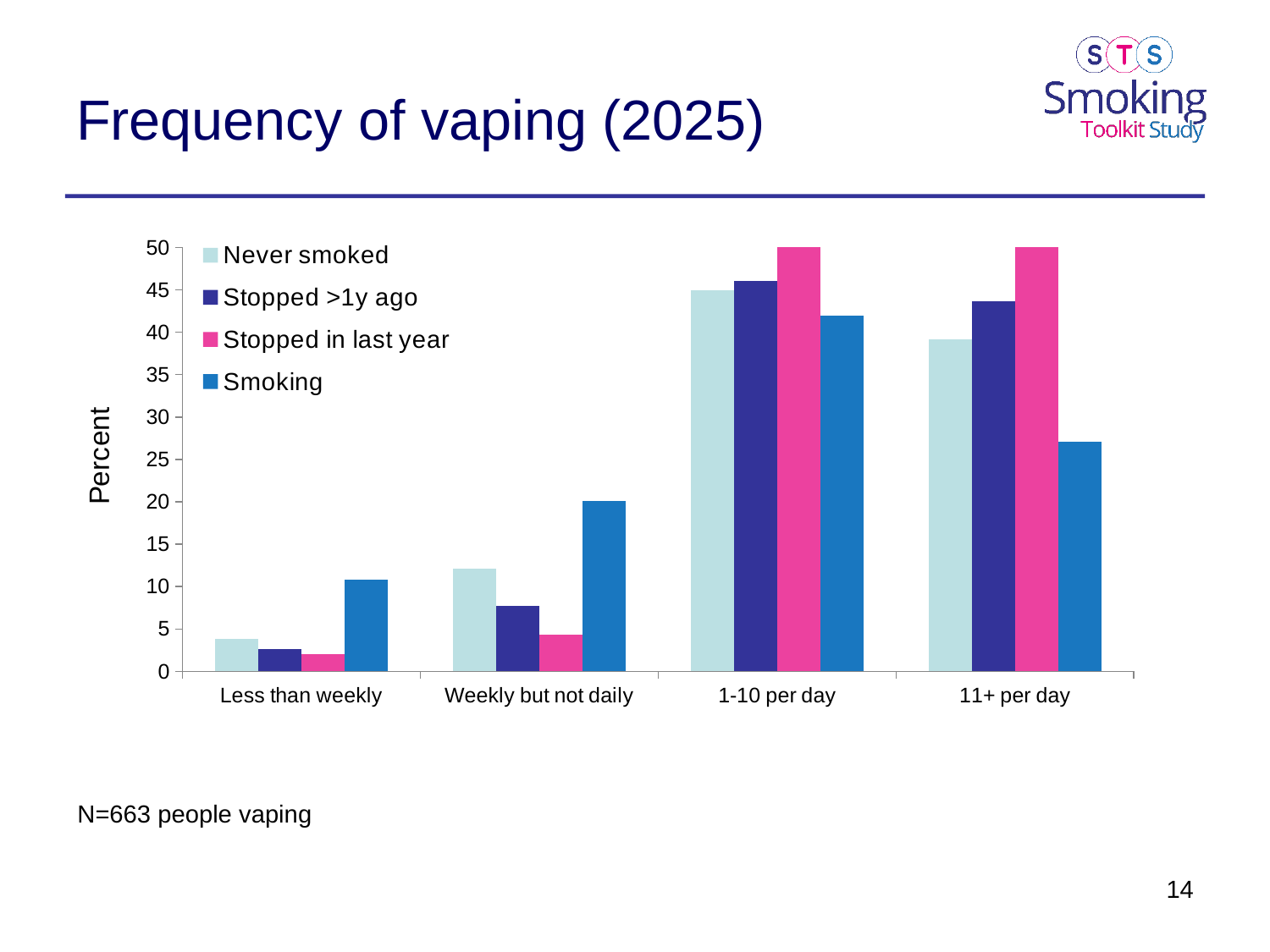
In the Weekly but not daily category, which is larger: Never smoked or Smoking? Smoking Is the value for Stopped >1y ago in the 1-10 per day category greater or less than 40? greater What kind of chart is shown on the slide? bar chart Is the value for Smoking in the Less than weekly category greater or less than 15? less Which series has the highest value in the 11+ per day category? Stopped in last year For the Smoking series, which category has the highest value? 1-10 per day How many vaping frequency categories are shown on the x axis? 4 Is the value for Never smoked in the 1-10 per day category greater or less than 40? greater What is the label on the y axis? Percent Which series has the lowest value in the Weekly but not daily category? Stopped in last year How many series does the legend list? 4